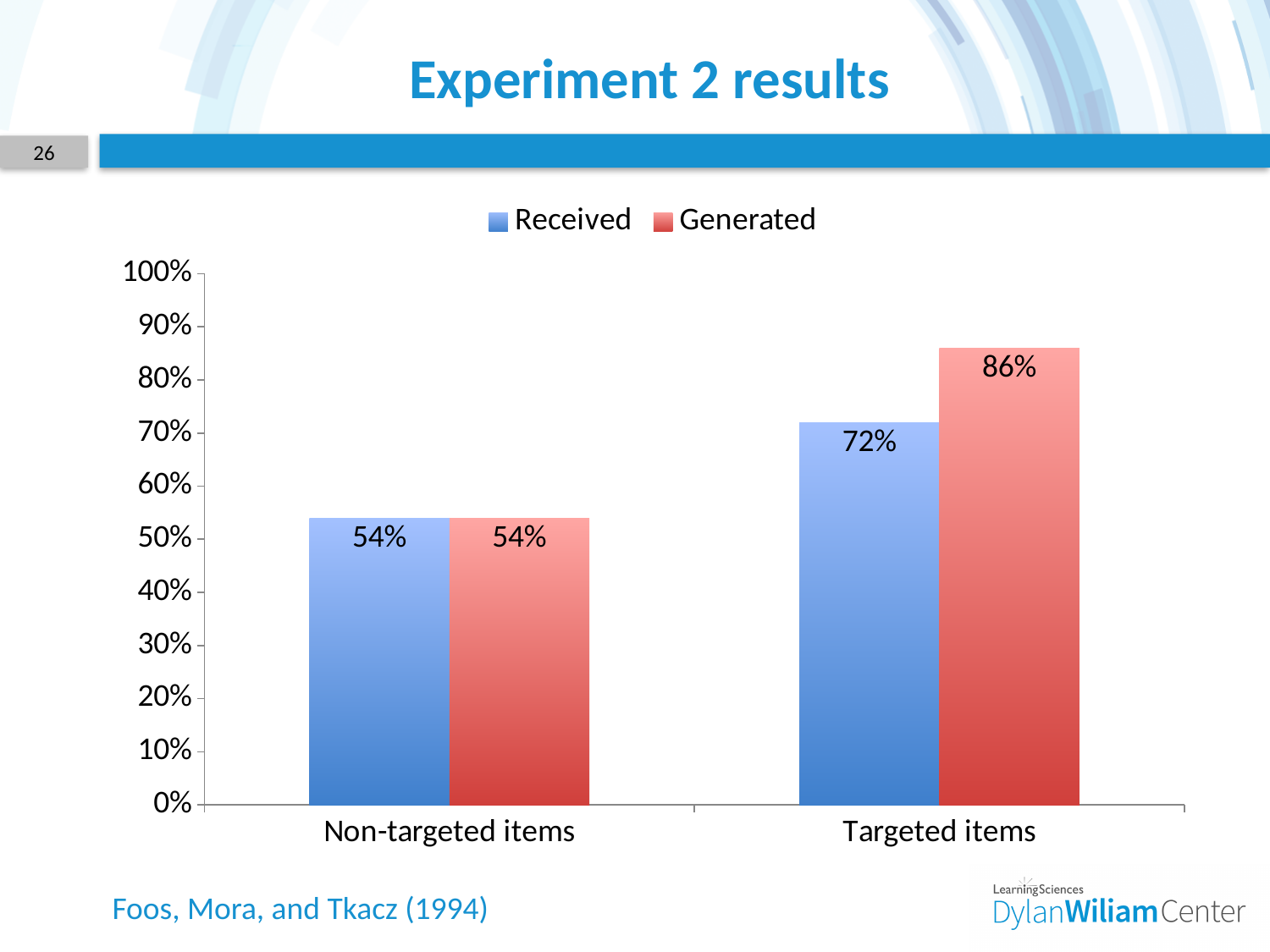
What is the Generated value for Targeted items? 86% What is the Generated value for Non-targeted items? 54% Which category has the lowest Received value? Non-targeted items What is the difference between the Generated and Received values for Targeted items? 14% What is the Received value for Non-targeted items? 54% How many categories are shown on the x axis? 2 What is the difference between the Received values for Targeted items and Non-targeted items? 18% Which category has the highest Generated value? Targeted items What is the Received value for Targeted items? 72% For Targeted items, which series has the larger value, Received or Generated? Generated What kind of chart is shown on the slide? Bar chart How many series does the legend list? 2